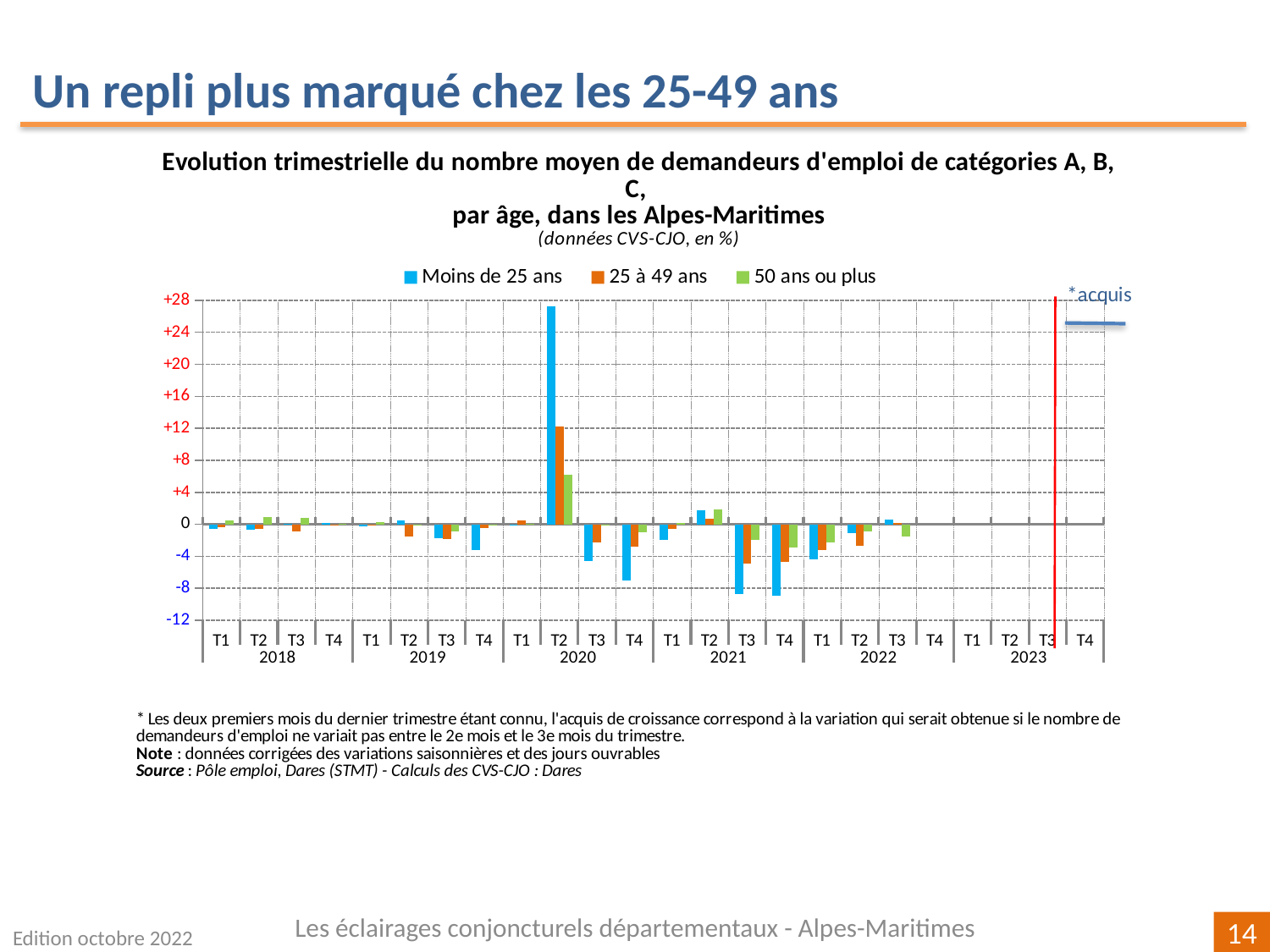
Is the value for 'Moins de 25 ans' in T4 2021 greater or less than -8? less In which quarter does the 'Moins de 25 ans' series reach its highest value? T2 2020 In T2 2020, which is larger: the value for '25 à 49 ans' or for '50 ans ou plus'? 25 à 49 ans How many years are labelled along the x axis? 6 How many series does the legend list? 3 Is the value for 'Moins de 25 ans' in T2 2020 greater or less than +24? greater What kind of chart is shown on the slide? bar chart Which series has the highest value in T2 2020? Moins de 25 ans What colour represents the '25 à 49 ans' series? orange Which series are listed in the legend? Moins de 25 ans, 25 à 49 ans, 50 ans ou plus Is the value for '25 à 49 ans' in T2 2020 greater or less than +8? greater